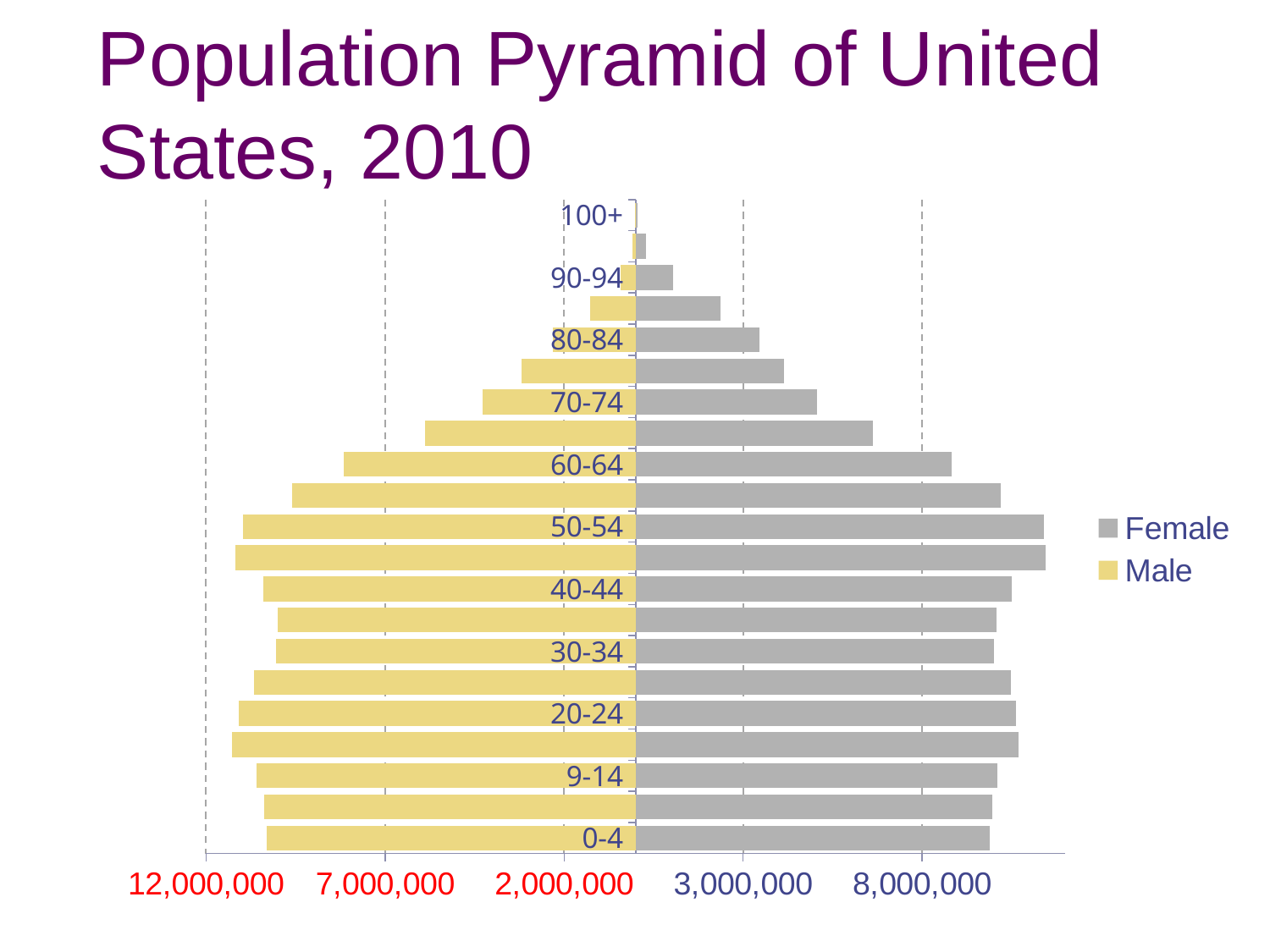
Is the Male value for the 0-4 age group greater or less than 7,000,000? greater Which age group has the smallest Male value? 100+ How many age groups (bars per series) are plotted? 21 Is the Female value for the 50-54 age group greater or less than 8,000,000? greater Which age group has the smallest Female value? 100+ How many series does the legend list? 2 Moving from the 50-54 age group up to 100+, do the Female bars get longer or shorter? shorter Which series is shown in gray? Female What kind of chart is shown on the slide? bar chart Which series is shown in yellow? Male Is the Female value for the 90-94 age group greater or less than 3,000,000? less Which is larger: the Female value for 50-54 or the Female value for 90-94? 50-54